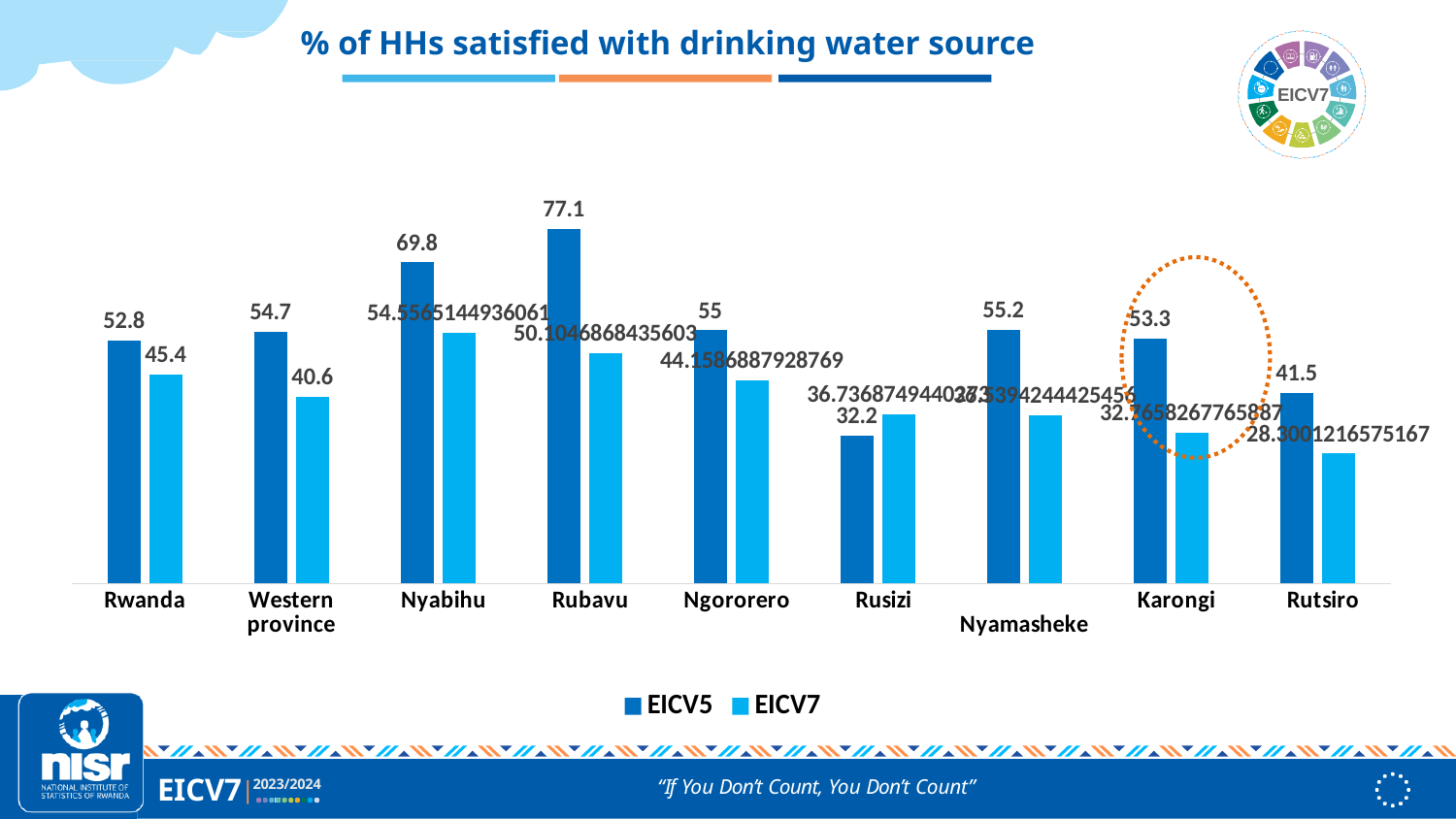
What is the EICV5 value for Rusizi? 32.2 Which category has the lowest EICV7 value? Rutsiro Which category has the lowest EICV5 value? Rusizi How many series does the legend list? 2 Which category has the highest EICV5 value? Rubavu For Rusizi, which is larger: the EICV5 value or the EICV7 value? EICV7 What is the EICV5 value for Rwanda? 52.8 What is the EICV7 value for Western province? 40.6 What is the EICV5 value for Rubavu? 77.1 What is the difference between the EICV5 and EICV7 values for Western province? 14.1 What is the difference between the EICV5 and EICV7 values for Rwanda? 7.4 How many categories are shown on the x axis? 9